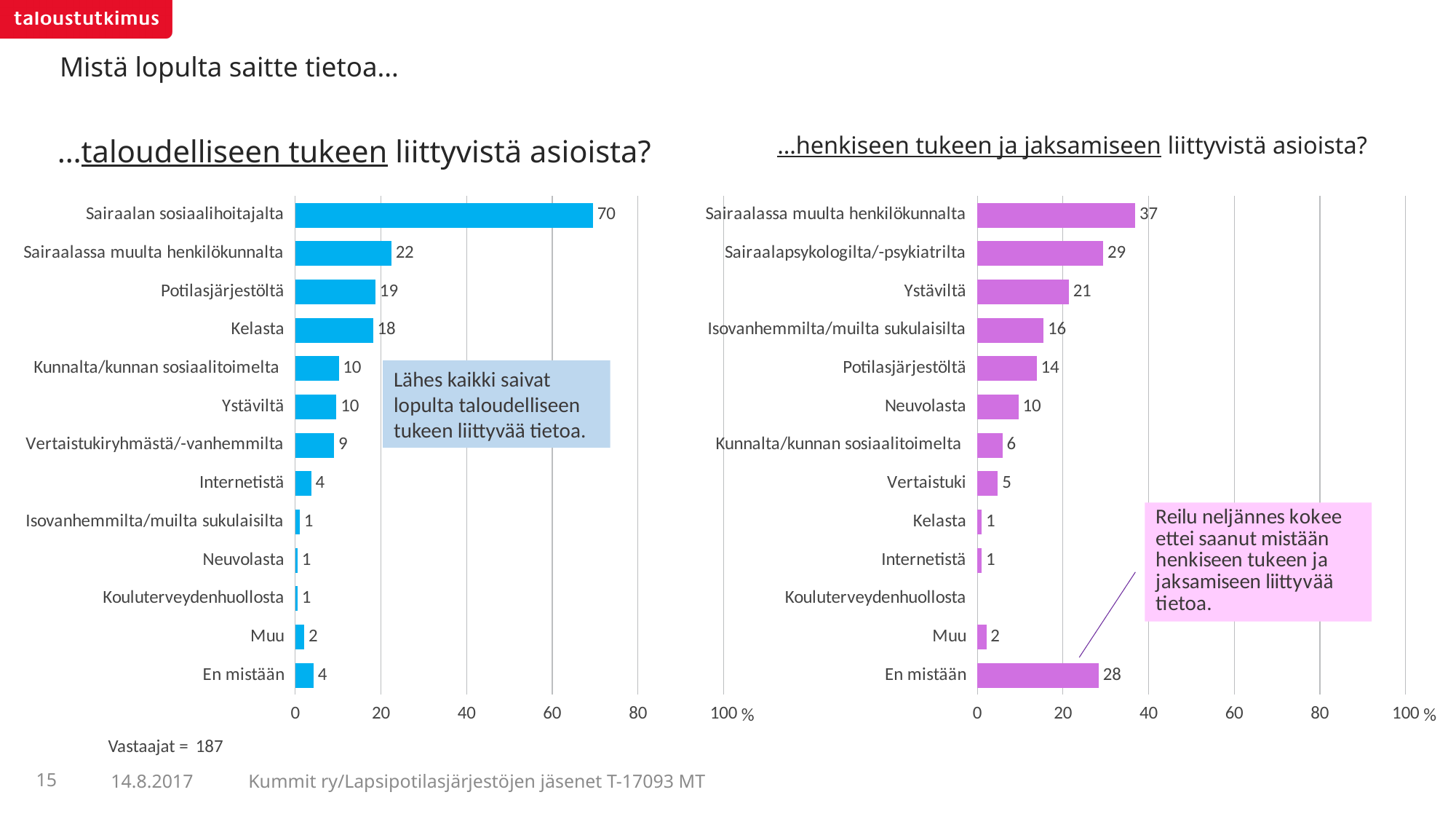
In the left chart (taloudelliseen tukeen), which is larger: Potilasjärjestöltä or Kelasta? Potilasjärjestöltä In the left chart (taloudelliseen tukeen), what is the value for Sairaalan sosiaalihoitajalta? 70 In the right chart (henkiseen tukeen ja jaksamiseen), which category has the highest value? Sairaalassa muulta henkilökunnalta In the left chart (taloudelliseen tukeen), which category has the highest value? Sairaalan sosiaalihoitajalta In the right chart (henkiseen tukeen ja jaksamiseen), is the value for Sairaalassa muulta henkilökunnalta greater or less than 20? greater In the right chart (henkiseen tukeen ja jaksamiseen), what is the difference between Ystäviltä and Isovanhemmilta/muilta sukulaisilta? 5 How many categories are shown in the left chart (taloudelliseen tukeen)? 13 In the right chart (henkiseen tukeen ja jaksamiseen), what is the value for En mistään? 28 In the right chart (henkiseen tukeen ja jaksamiseen), what is the value for Sairaalapsykologilta/-psykiatrilta? 29 In the left chart (taloudelliseen tukeen), what is the difference between Sairaalan sosiaalihoitajalta and Sairaalassa muulta henkilökunnalta? 48 What colour are the bars in the left chart (taloudelliseen tukeen)? blue What kind of chart is the right chart (henkiseen tukeen ja jaksamiseen)? bar chart